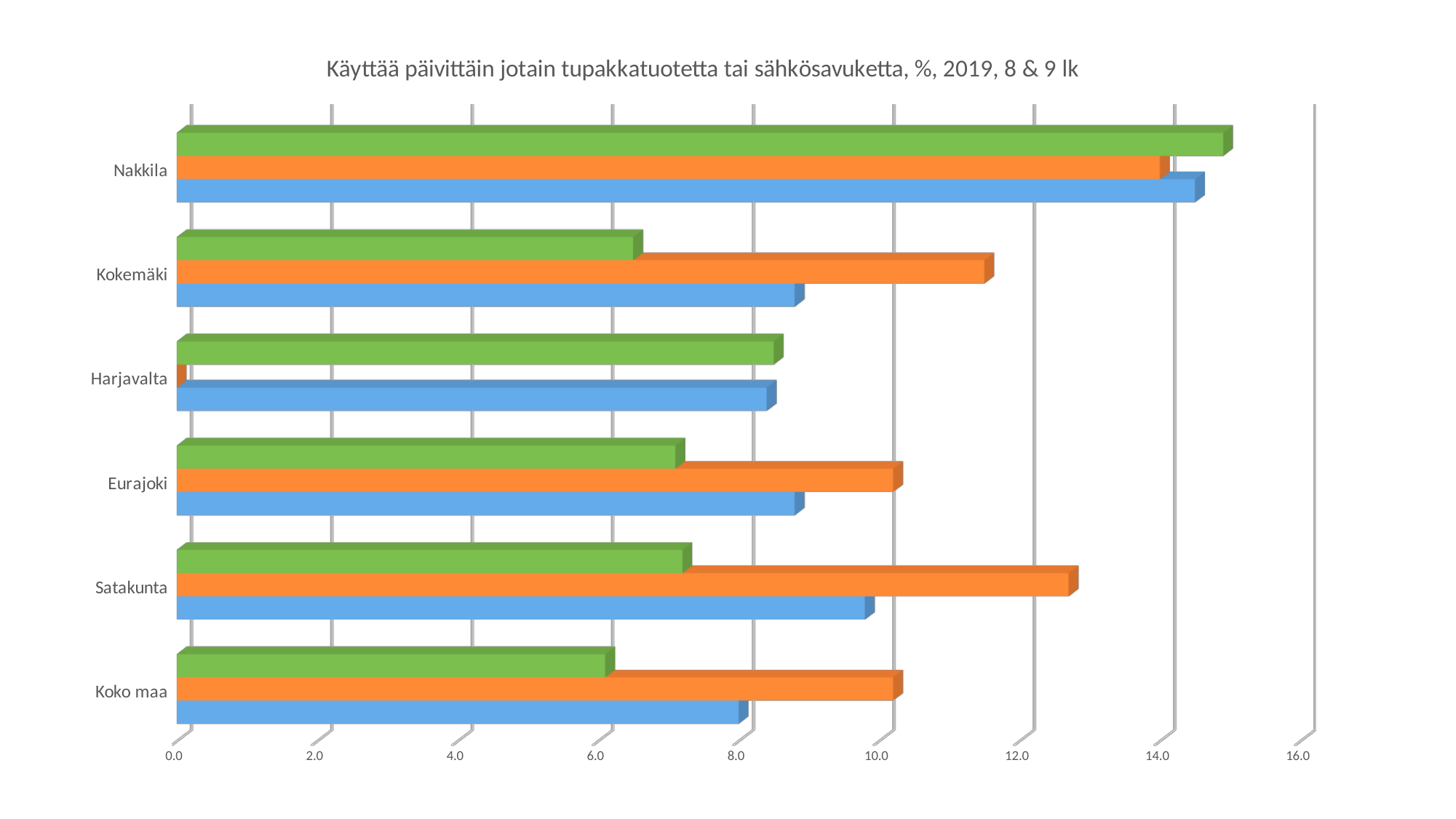
Which category has the longest green bar? Nakkila What is the title of the chart? Käyttää päivittäin jotain tupakkatuotetta tai sähkösavuketta, %, 2019, 8 & 9 lk Which category has the shortest orange bar? Harjavalta What kind of chart is shown on the slide? bar chart How many categories are shown on the vertical axis of the chart? 6 Is the orange bar for Satakunta greater or less than 12.0? greater Is the blue bar for Koko maa greater or less than 10.0? less Which category has the longest blue bar? Nakkila For Kokemäki, which is longer: the orange bar or the green bar? the orange bar Is the orange bar for Harjavalta greater or less than 2.0? less How many bars are shown for each category in the chart? 3